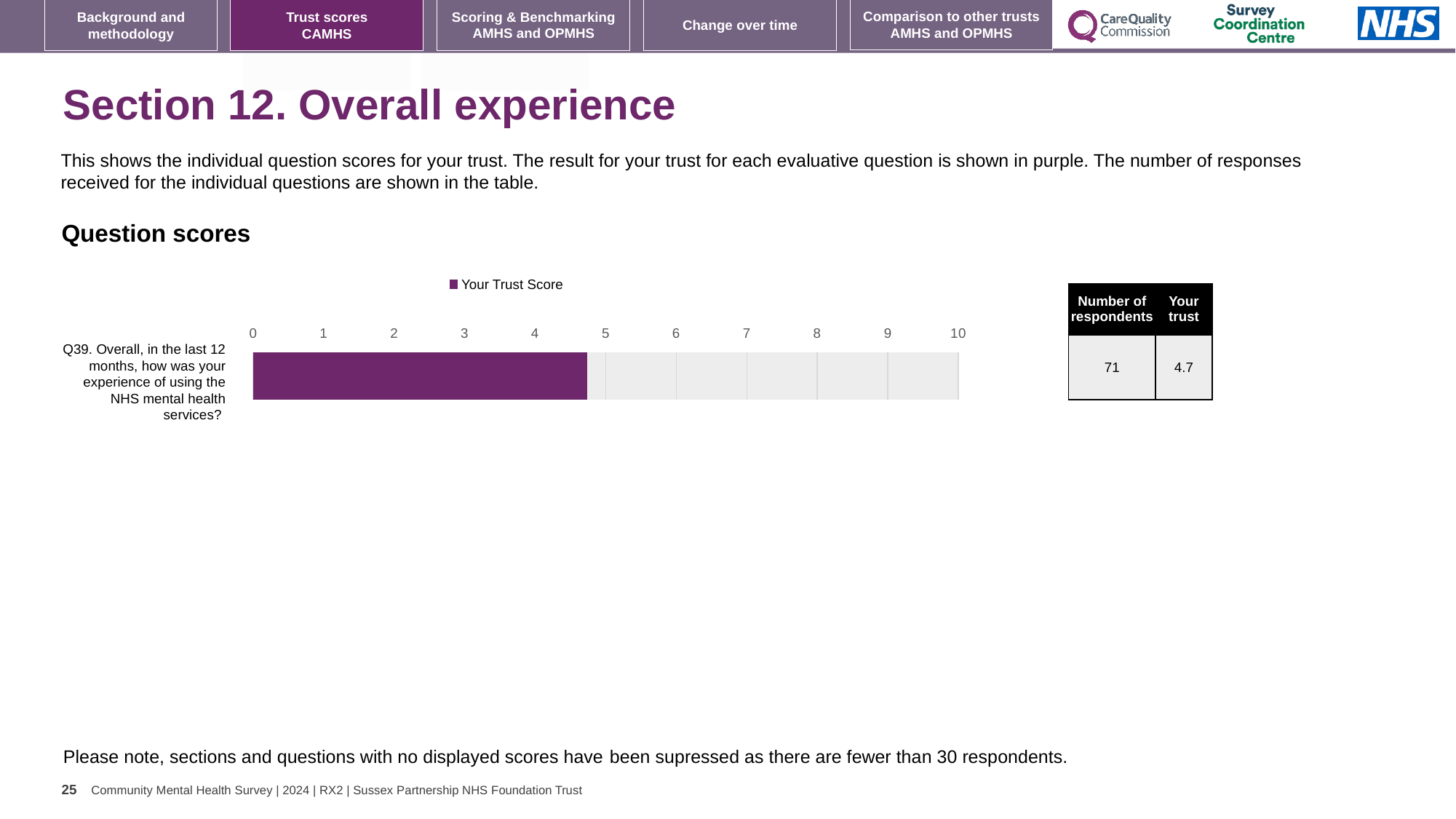
Is the trust score for Q39 greater or less than 3? greater How many respondents answered Q39, according to the table next to the chart? 71 Is the trust score for Q39 greater or less than 5? less What colour is the bar for Q39 in the Question scores chart? purple Is the trust score for Q39 greater or less than 4? greater What is the trust score for Q39, as shown in the 'Your trust' column of the table? 4.7 What kind of chart is shown under 'Question scores'? bar chart How many series does the legend of the Question scores chart list? 1 What is the name of the series shown in the legend of the Question scores chart? Your Trust Score How many questions (categories) are plotted in the Question scores chart? 1